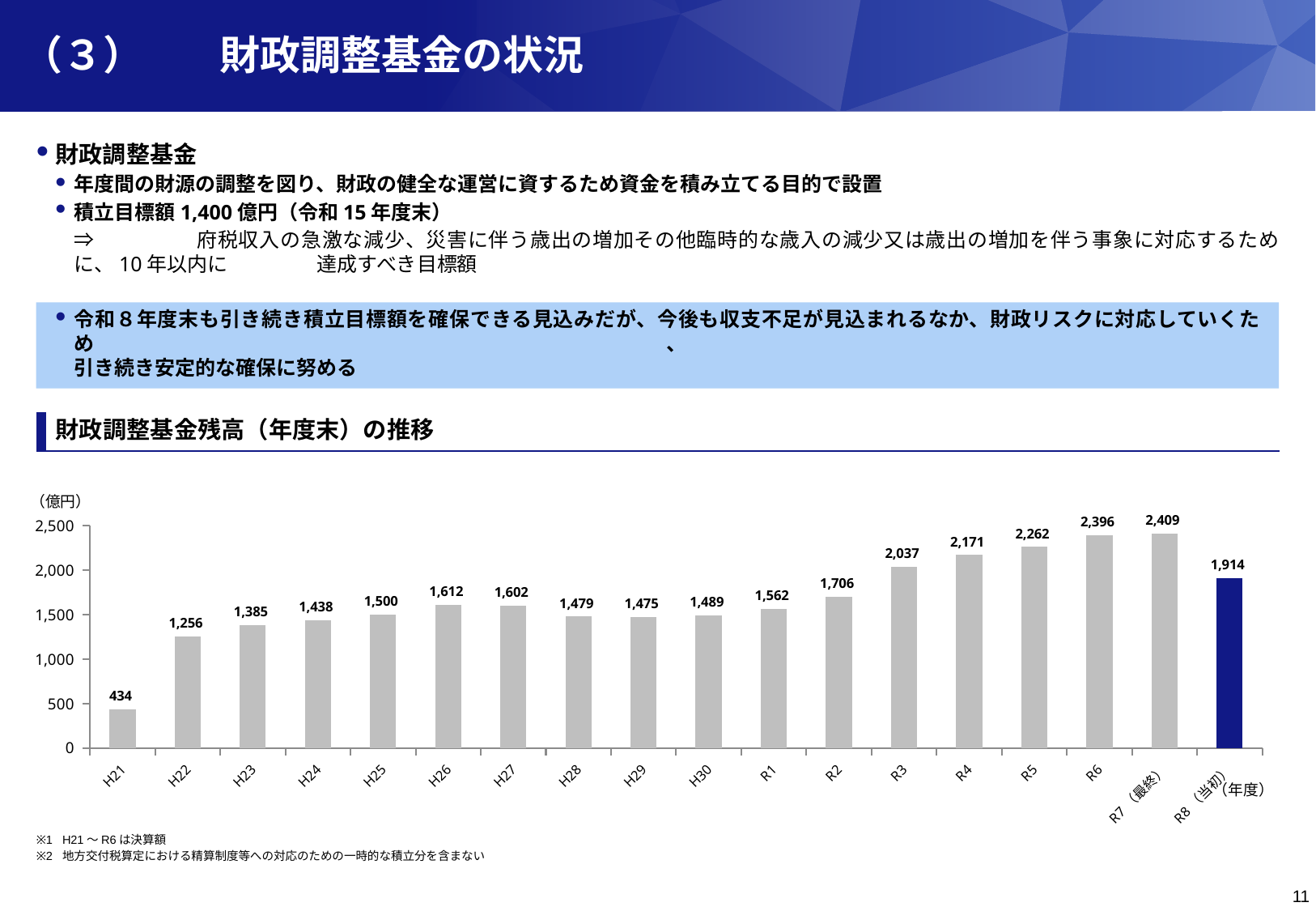
Which is larger, the value for H25 or the value for R1? R1 Which year has the lowest value in the chart? H21 What type of chart is shown on the slide? bar chart Which year has the highest value in the chart? R7（最終） What is the difference between the values for R7（最終） and R8（当初）? 495 Do the values rise or fall from R3 to R7（最終）? rise What is the value for H21 in the 財政調整基金残高 chart? 434 What is the difference between the values for R3 and R2? 331 What is the value for H26 in the chart? 1,612 What is the value for R8（当初） in the chart? 1,914 What is the value for R6 in the chart? 2,396 How many years (bars) are shown in the chart? 18